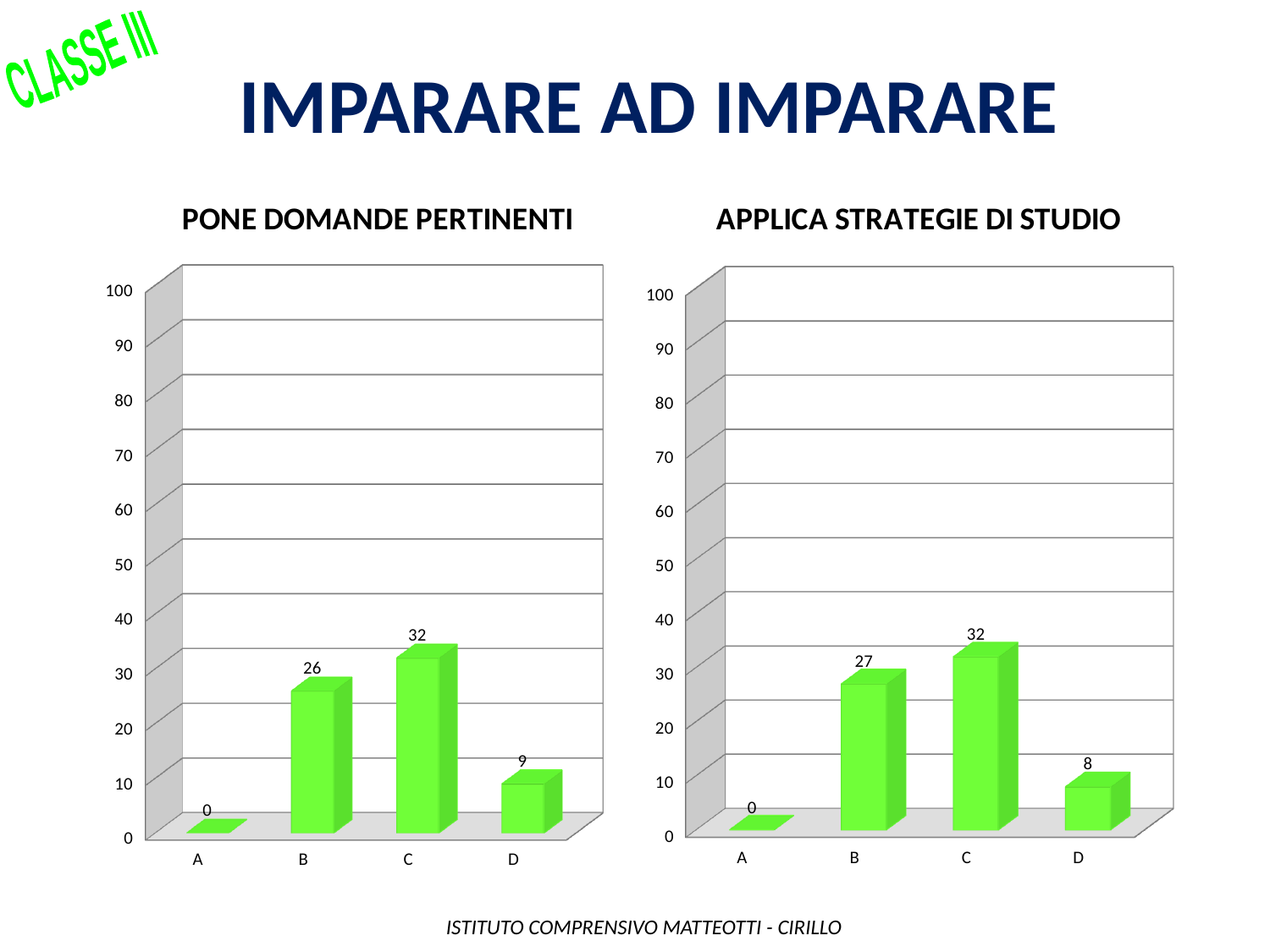
In the 'PONE DOMANDE PERTINENTI' chart, what is the difference between the values for C and B? 6 In the 'PONE DOMANDE PERTINENTI' chart, which category has the highest value? C How many categories are shown in the 'APPLICA STRATEGIE DI STUDIO' chart? 4 In the 'PONE DOMANDE PERTINENTI' chart, is the value for C greater or less than 40? less In the 'APPLICA STRATEGIE DI STUDIO' chart, what is the value for category D? 8 In the 'APPLICA STRATEGIE DI STUDIO' chart, what is the difference between the values for B and D? 19 In the 'APPLICA STRATEGIE DI STUDIO' chart, which is larger, the value for B or the value for D? B In the 'PONE DOMANDE PERTINENTI' chart, what is the value for category B? 26 What is the title of the chart on the right side of the slide? APPLICA STRATEGIE DI STUDIO In the 'APPLICA STRATEGIE DI STUDIO' chart, which category has the lowest value? A What kind of chart is 'PONE DOMANDE PERTINENTI'? bar chart In the 'PONE DOMANDE PERTINENTI' chart, what is the value for category A? 0